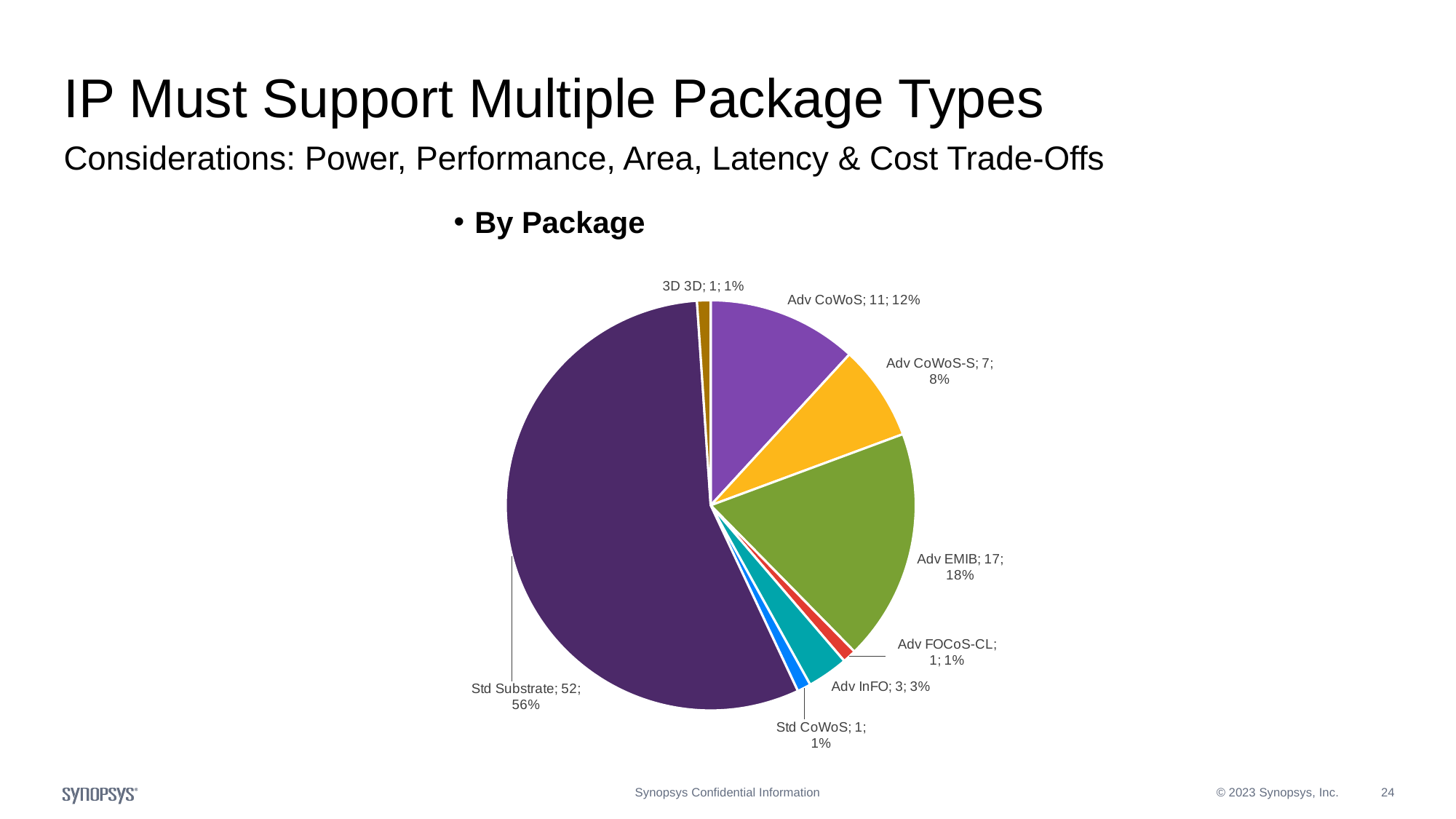
What is the difference in count between Adv EMIB and Adv CoWoS? 6 What is the count for Adv CoWoS? 11 What type of chart is shown on the slide? Pie chart What percentage share does Adv CoWoS-S have? 8% What percentage share does Std Substrate have? 56% What percentage share does Adv EMIB have? 18% What is the title of the chart? By Package What is the count for Std Substrate? 52 How many slices does the pie chart have? 8 Which package type has the largest slice? Std Substrate Which is larger, Adv CoWoS-S or Adv InFO? Adv CoWoS-S What is the count for Adv InFO? 3